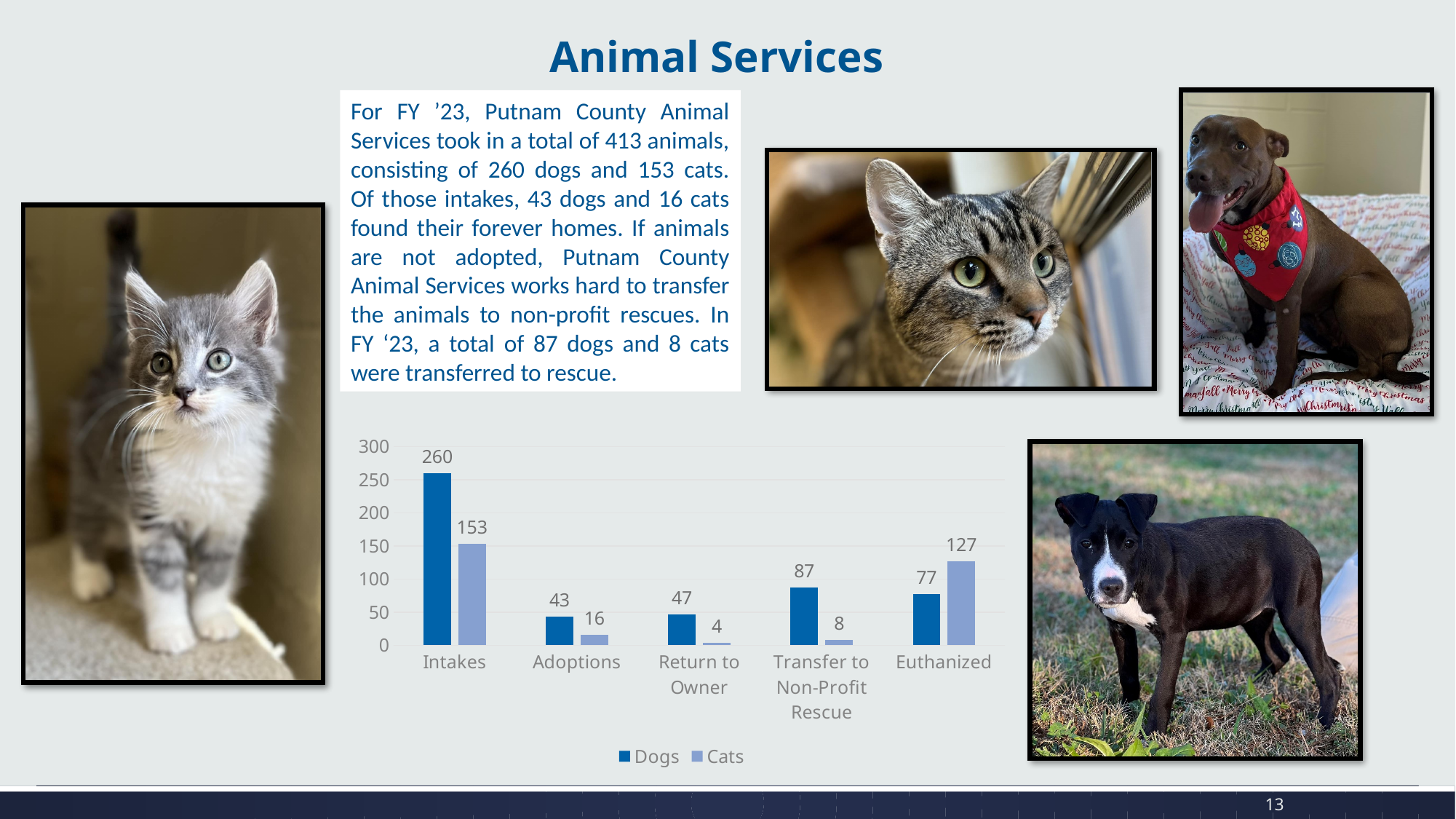
How many categories are shown on the x axis? 5 What kind of chart is shown on the slide? bar chart Which category has the highest value for Dogs? Intakes Is the value for Dogs in the Transfer to Non-Profit Rescue category greater or less than 50? greater In the Euthanized category, which is larger, Dogs or Cats? Cats How many series does the legend list? 2 Which category has the lowest value for Cats? Return to Owner What is the value for Cats in the Euthanized category? 127 What is the difference between Dogs and Cats in the Intakes category? 107 What are the two series named in the legend? Dogs and Cats What is the value for Dogs in the Intakes category? 260 What is the value for Cats in the Return to Owner category? 4